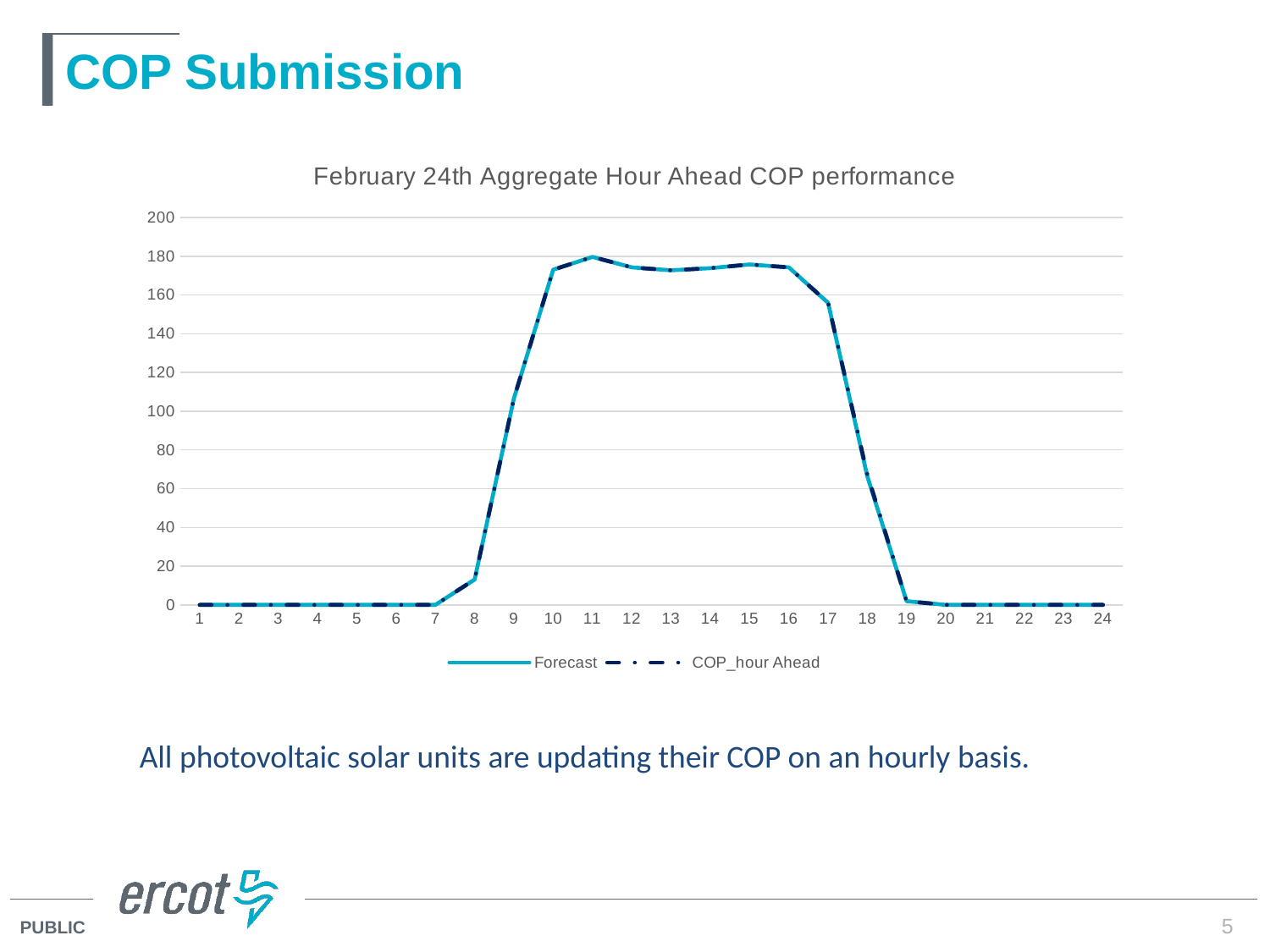
What is the title of the chart? February 24th Aggregate Hour Ahead COP performance What is the Forecast value at hour 3? 0 What kind of chart is shown on the slide? Line chart Is the Forecast value at hour 17 greater or less than 140? greater How many hours are shown along the x axis? 24 At which hour does the Forecast series reach its highest value? 11 How many series does the legend list? 2 Is the COP_hour Ahead value at hour 18 greater or less than 80? less Which is larger, the Forecast value at hour 9 or at hour 17? Hour 17 Do the values rise or fall between hour 16 and hour 19? Fall Is the Forecast value at hour 9 greater or less than 120? less What are the names of the two series in the legend? Forecast and COP_hour Ahead